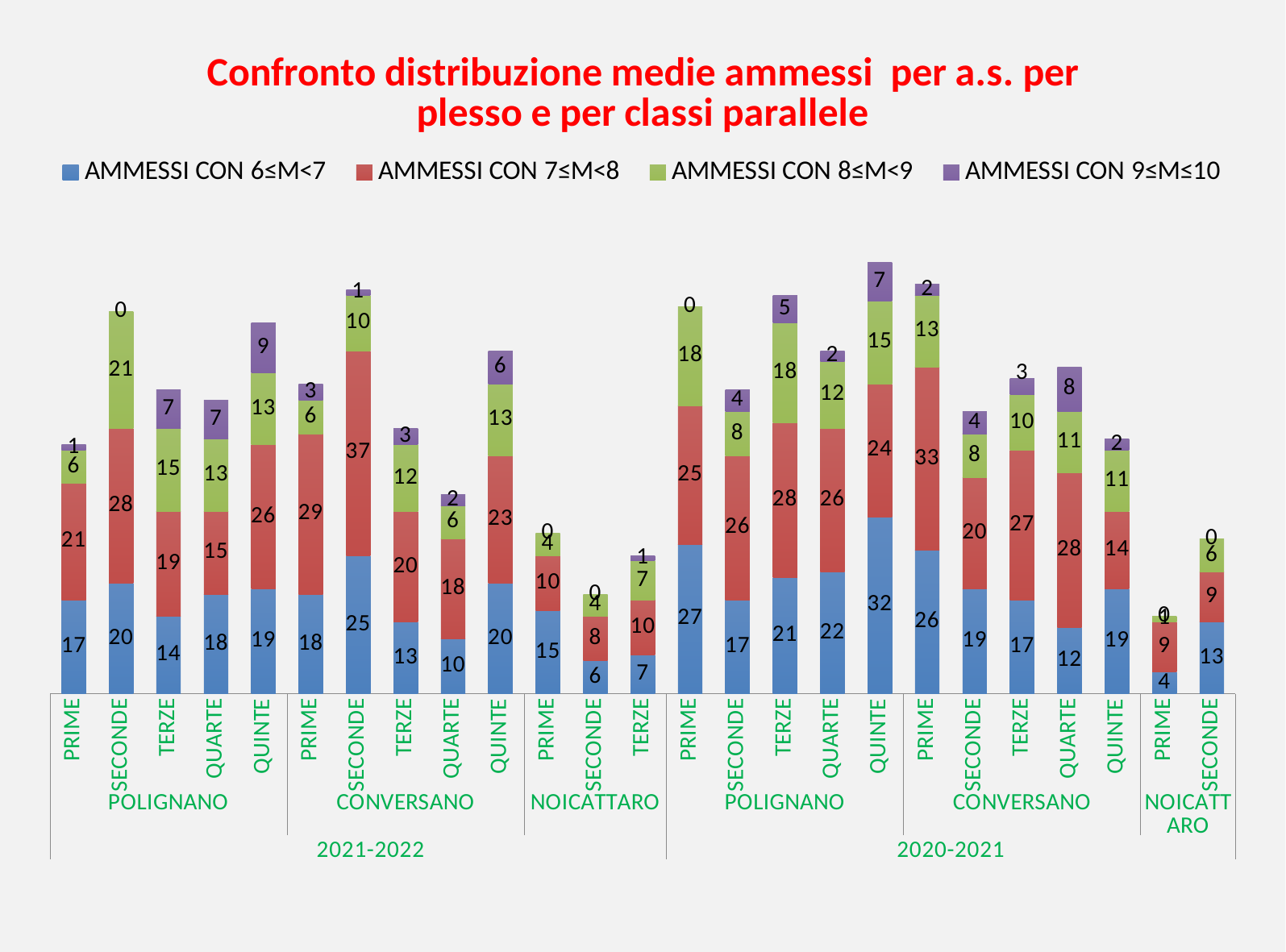
What is the value of AMMESSI CON 6≤M<7 for QUINTE in POLIGNANO in 2020-2021? 32 What is the value of AMMESSI CON 9≤M≤10 for QUARTE in CONVERSANO in 2020-2021? 8 Which is larger: AMMESSI CON 8≤M<9 for TERZE in POLIGNANO in 2020-2021 or for TERZE in POLIGNANO in 2021-2022? TERZE in POLIGNANO in 2020-2021 Which bar has the lowest value for AMMESSI CON 6≤M<7? PRIME, NOICATTARO, 2020-2021 What is the value of AMMESSI CON 8≤M<9 for SECONDE in POLIGNANO in 2021-2022? 21 What is the value of AMMESSI CON 7≤M<8 for SECONDE in CONVERSANO in 2021-2022? 37 What is the difference between AMMESSI CON 7≤M<8 for PRIME in CONVERSANO in 2020-2021 and for PRIME in CONVERSANO in 2021-2022? 4 What is the total of the stacked bar for PRIME in POLIGNANO in 2021-2022? 45 What kind of chart is shown on the slide? stacked bar chart How many stacked bars are plotted in the chart? 25 How many series does the legend list? 4 Which bar has the highest value for AMMESSI CON 6≤M<7? QUINTE, POLIGNANO, 2020-2021